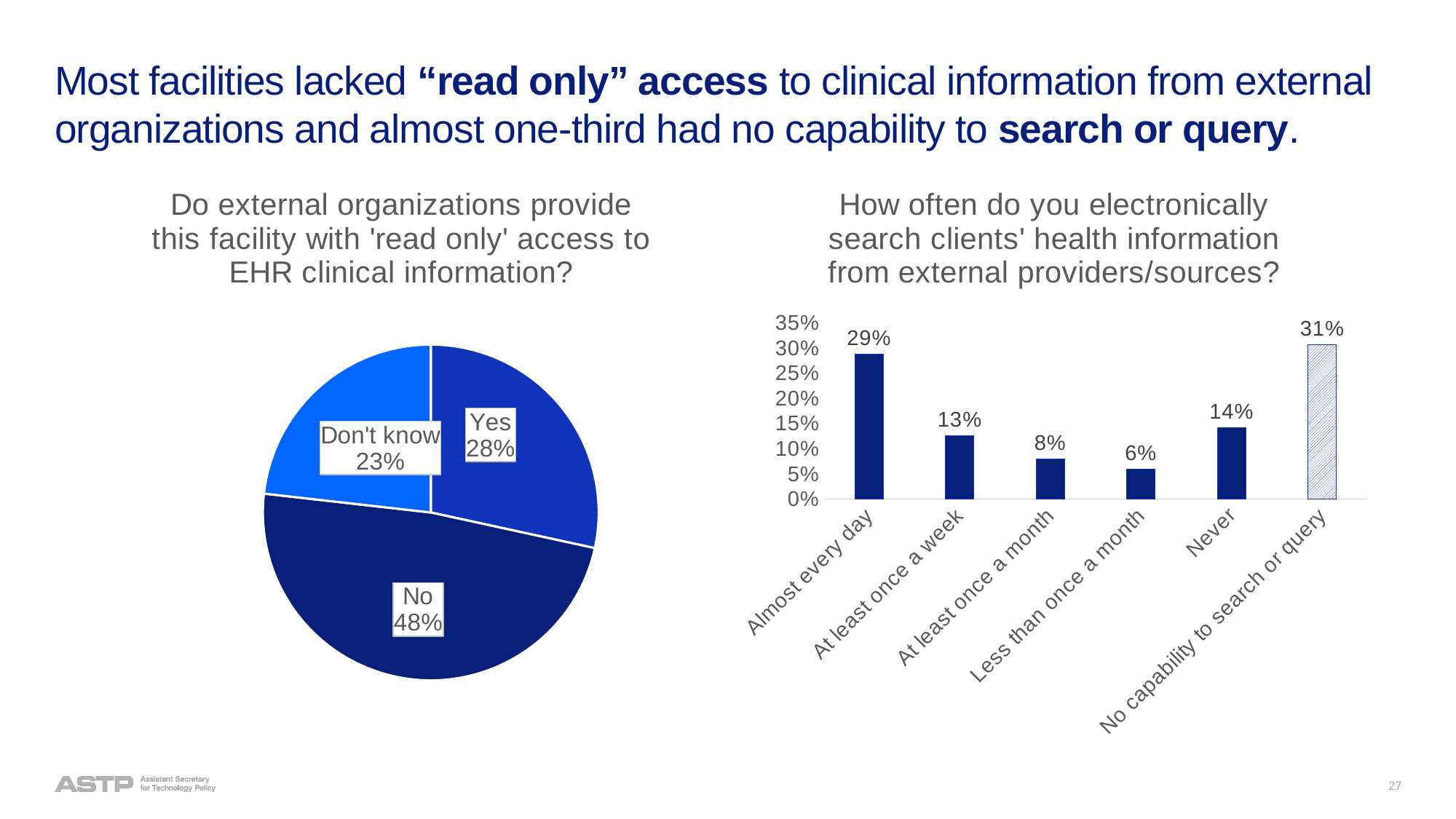
What type of chart is on the right side of the slide? Bar chart In the bar chart on the right, what is the difference between 'At least once a week' and 'At least once a month'? 5% In the pie chart on the left, what share of facilities answered 'Yes'? 28% In the pie chart on the left, what share of facilities answered 'No'? 48% In the pie chart on the left, what is the difference between the 'No' and 'Yes' shares? 20% In the pie chart on the left, which response has the smallest share? Don't know In the bar chart on the right, how many categories are shown? 6 In the bar chart on the right, what is the value for 'Never'? 14% In the bar chart on the right, which category has the highest value? No capability to search or query In the bar chart on the right, which category has the lowest value? Less than once a month In the bar chart on the right, what is the value for 'Almost every day'? 29% In the pie chart on the left, how many slices are there? 3